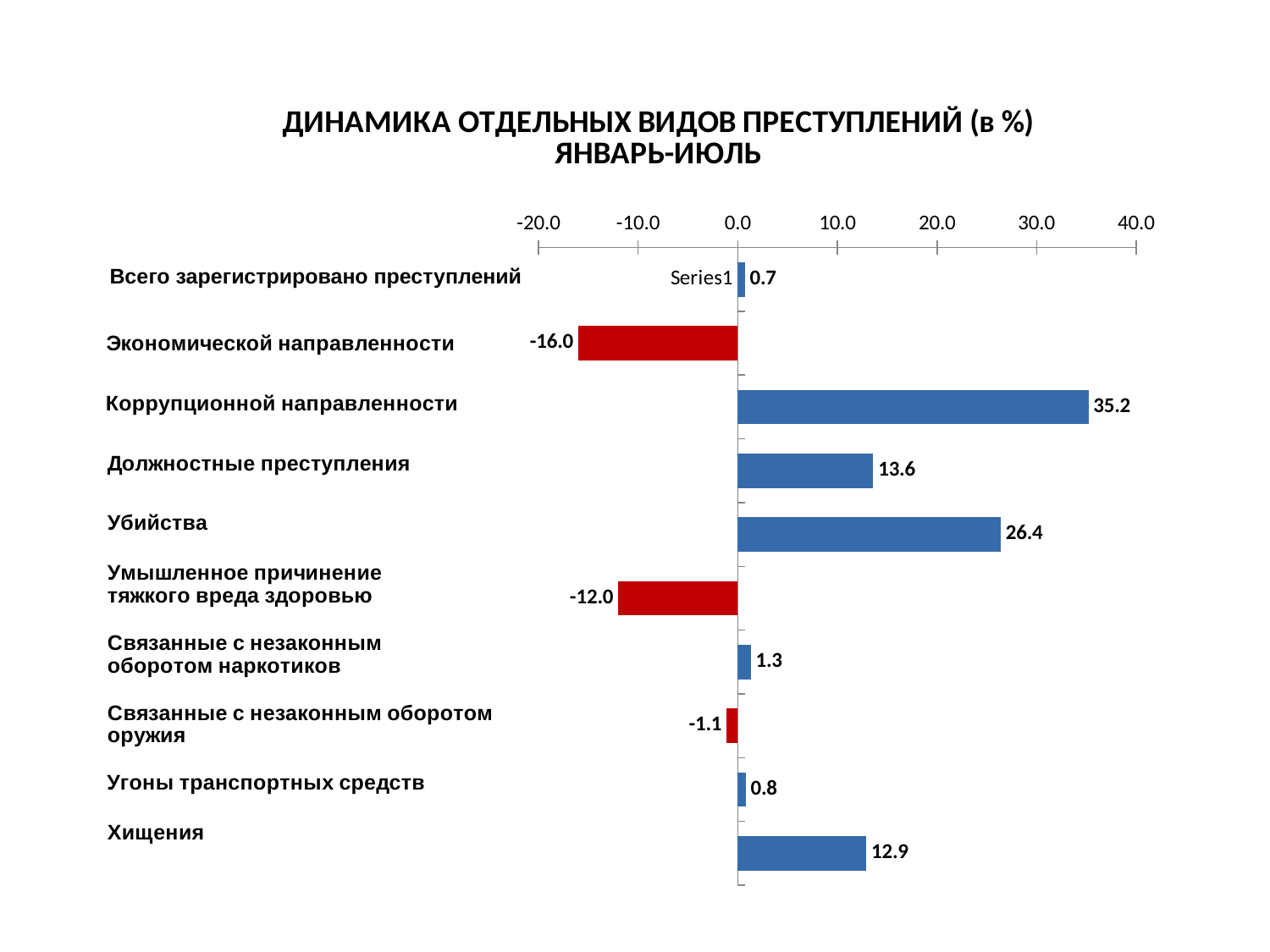
Is the value for Коррупционной направленности greater or less than 30.0? greater What type of chart is shown on the slide? Bar chart Which category has the highest value? Коррупционной направленности Which is larger, the value for Должностные преступления or the value for Хищения? Должностные преступления How many categories are shown in the chart? 10 What is the difference between the values for Коррупционной направленности and Убийства? 8.8 What is the value for Коррупционной направленности? 35.2 Which category has the lowest value? Экономической направленности What is the value for Убийства? 26.4 What is the title of the chart? ДИНАМИКА ОТДЕЛЬНЫХ ВИДОВ ПРЕСТУПЛЕНИЙ (в %) ЯНВАРЬ-ИЮЛЬ What is the value for Экономической направленности? -16.0 What is the value for Хищения? 12.9